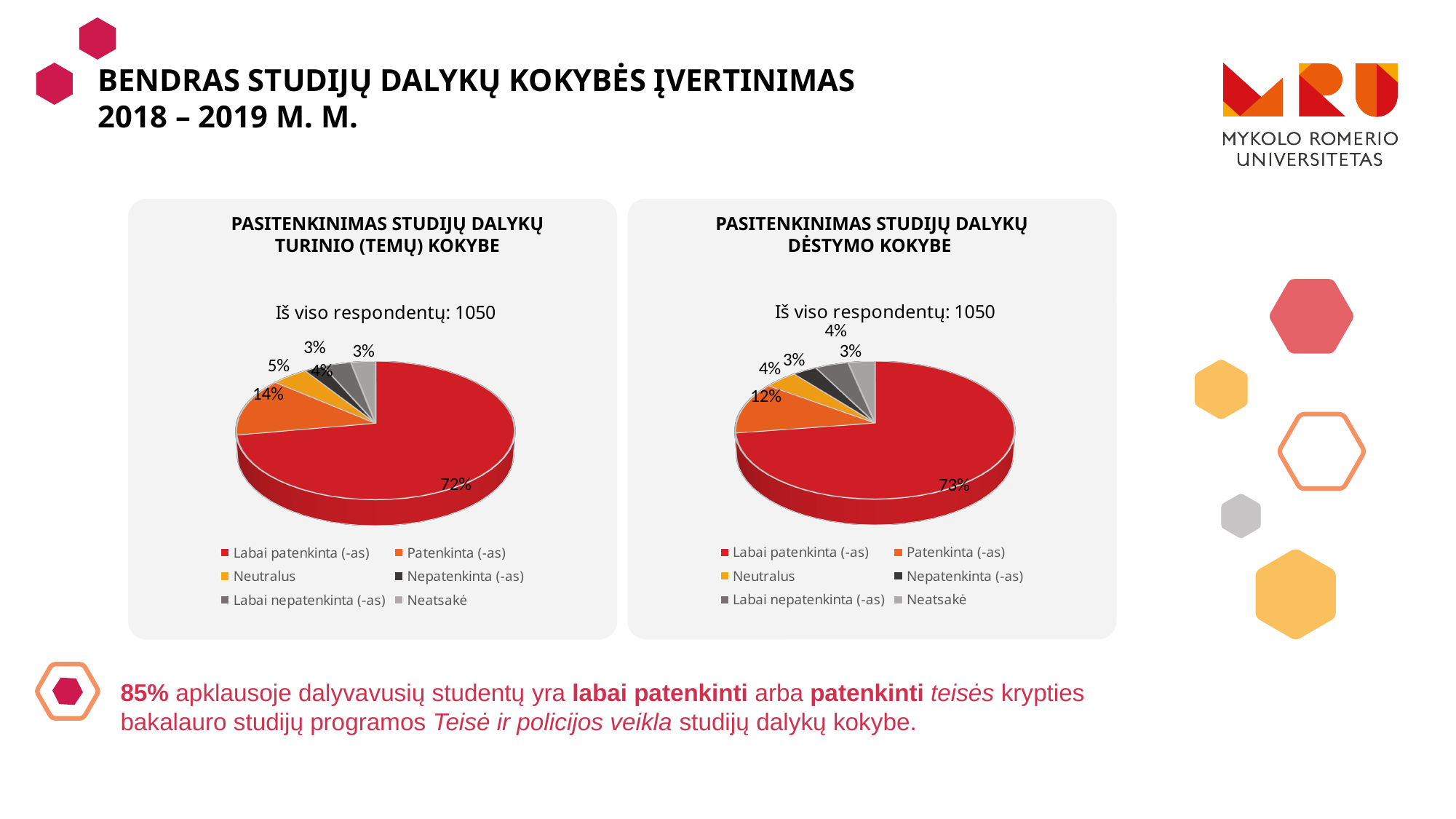
In the right chart, 'Pasitenkinimas studijų dalykų dėstymo kokybe', what share is 'Labai patenkinta (-as)'? 73% In the right chart, 'Pasitenkinimas studijų dalykų dėstymo kokybe', what is the combined share of 'Labai patenkinta (-as)' and 'Patenkinta (-as)'? 85% In the right chart, 'Pasitenkinimas studijų dalykų dėstymo kokybe', which category has the largest share? Labai patenkinta (-as) In the left chart, 'Pasitenkinimas studijų dalykų turinio (temų) kokybe', what is the difference between the 'Labai patenkinta (-as)' and 'Patenkinta (-as)' shares? 58% In the left chart, 'Pasitenkinimas studijų dalykų turinio (temų) kokybe', what share is 'Neutralus'? 5% How many categories does the legend of the right chart, 'Pasitenkinimas studijų dalykų dėstymo kokybe', list? 6 In the right chart, 'Pasitenkinimas studijų dalykų dėstymo kokybe', what share is 'Patenkinta (-as)'? 12% In the left chart, 'Pasitenkinimas studijų dalykų turinio (temų) kokybe', what share is 'Patenkinta (-as)'? 14% What kind of chart is used in the left chart, 'Pasitenkinimas studijų dalykų turinio (temų) kokybe'? Pie chart In the left chart, 'Pasitenkinimas studijų dalykų turinio (temų) kokybe', what share is 'Labai patenkinta (-as)'? 72% Which chart has the larger 'Patenkinta (-as)' share, the left chart (turinio kokybe) or the right chart (dėstymo kokybe)? The left chart (turinio kokybe) How many respondents does the left chart, 'Pasitenkinimas studijų dalykų turinio (temų) kokybe', report in total? 1050